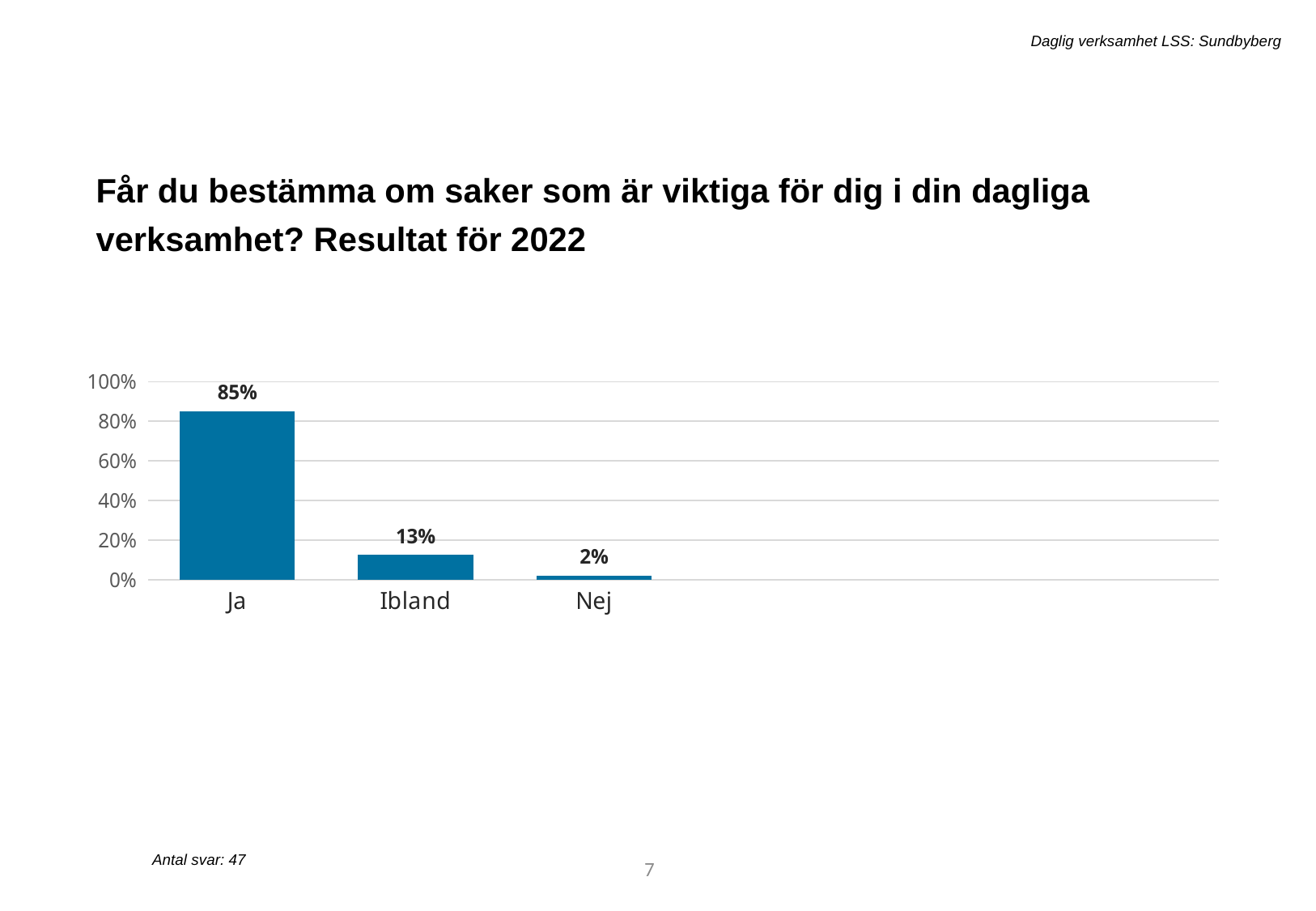
What is the value for Nej? 2% How many categories are shown on the x axis? 3 How many responses (Antal svar) does the slide report? 47 What is the value for Ja? 85% Is the value for Ja greater or less than 80%? greater What is the difference between the values for Ja and Ibland? 72% What kind of chart is shown on the slide? bar chart What is the value for Ibland? 13% Which category has the highest value? Ja What is the difference between the values for Ibland and Nej? 11% Which is larger, the value for Ibland or the value for Nej? Ibland Which category has the lowest value? Nej